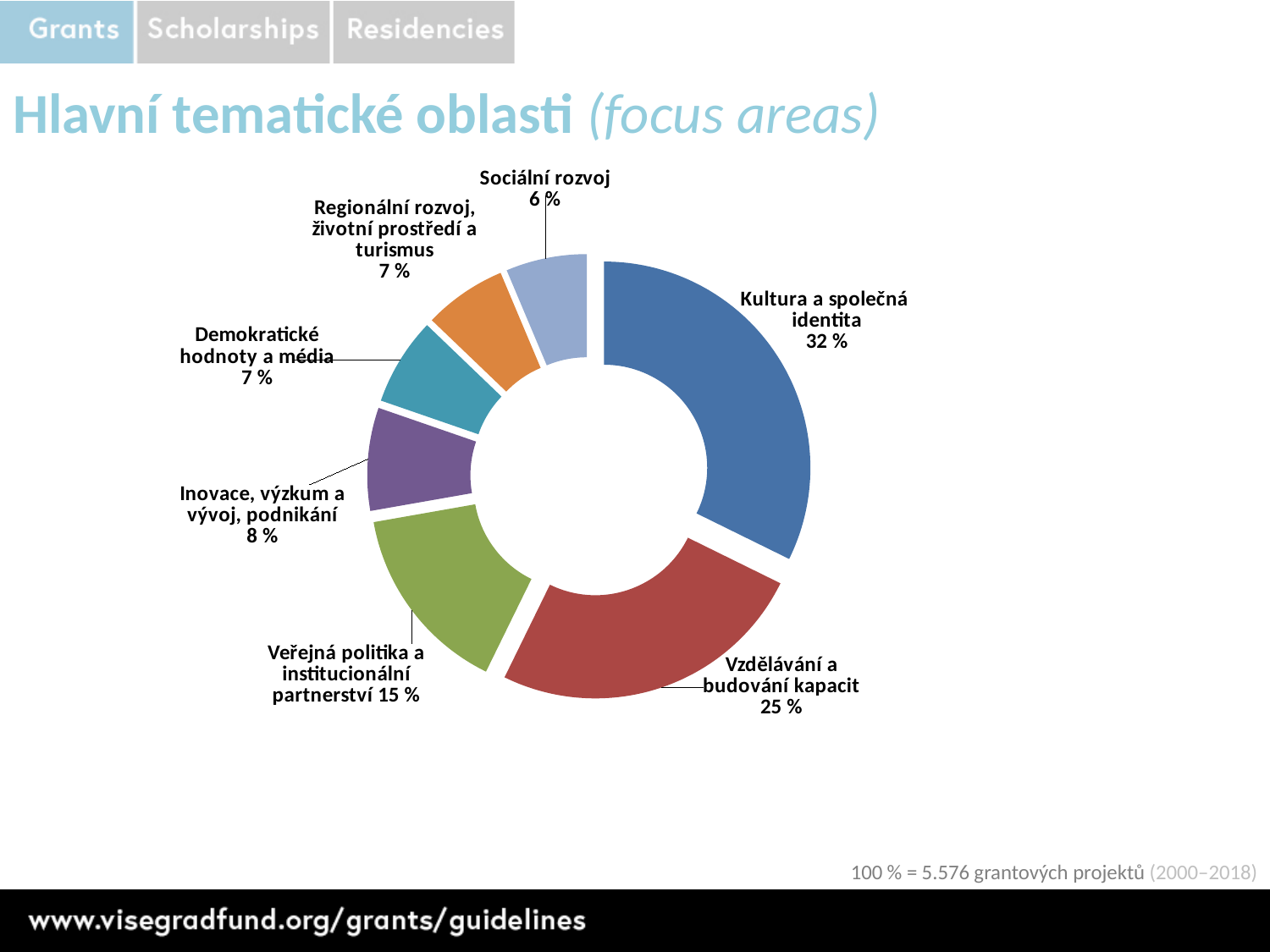
What is the value shown for "Vzdělávání a budování kapacit"? 25 % What share of the chart does "Kultura a společná identita" represent? 32 % According to the note on the slide, how many grant projects does 100 % correspond to? 5.576 grantových projektů Which is larger: the share for "Veřejná politika a institucionální partnerství" or for "Inovace, výzkum a vývoj, podnikání"? Veřejná politika a institucionální partnerství What percentage is shown for "Veřejná politika a institucionální partnerství"? 15 % How many focus areas (slices) are shown in the chart? 7 What is the difference in percentage points between "Kultura a společná identita" and "Vzdělávání a budování kapacit"? 7 % What share is shown for "Sociální rozvoj"? 6 % What type of chart is shown on the slide? Doughnut (pie) chart What is the value for "Inovace, výzkum a vývoj, podnikání"? 8 % Which focus area has the largest share in the chart? Kultura a společná identita Which focus area has the smallest share in the chart? Sociální rozvoj